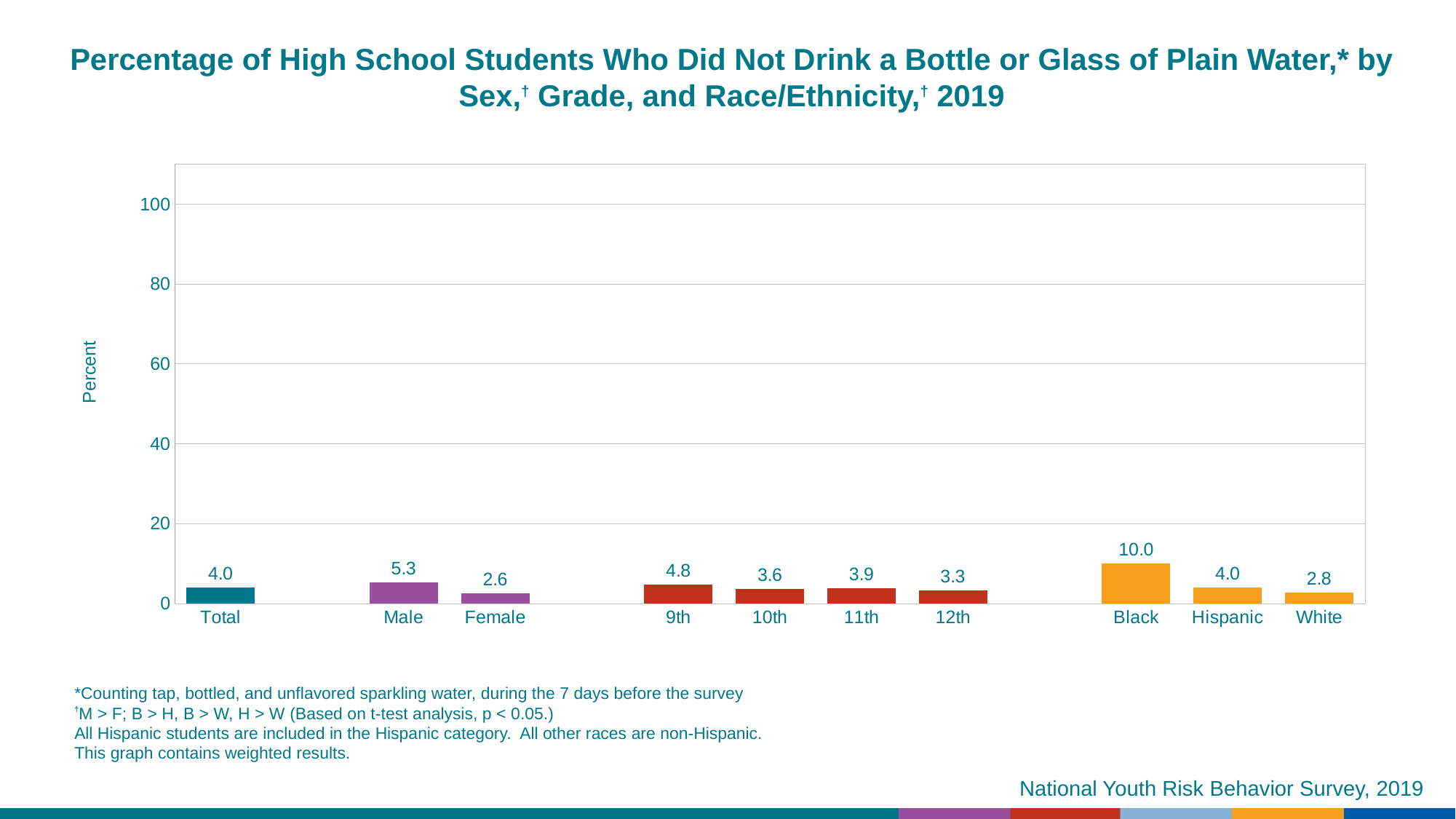
What kind of chart is shown on the slide? bar chart What is the label of the y axis? Percent Which category has the highest value? Black Which category has the lowest value? Female What is the value for Male? 5.3 Is the value for Black greater or less than 20? less How many categories are shown on the x axis? 10 Which is larger, the value for 9th grade or the value for 10th grade? 9th What is the difference between the Male and Female values? 2.7 What is the value for Black? 10.0 What is the value for 12th grade? 3.3 What is the value for Total? 4.0